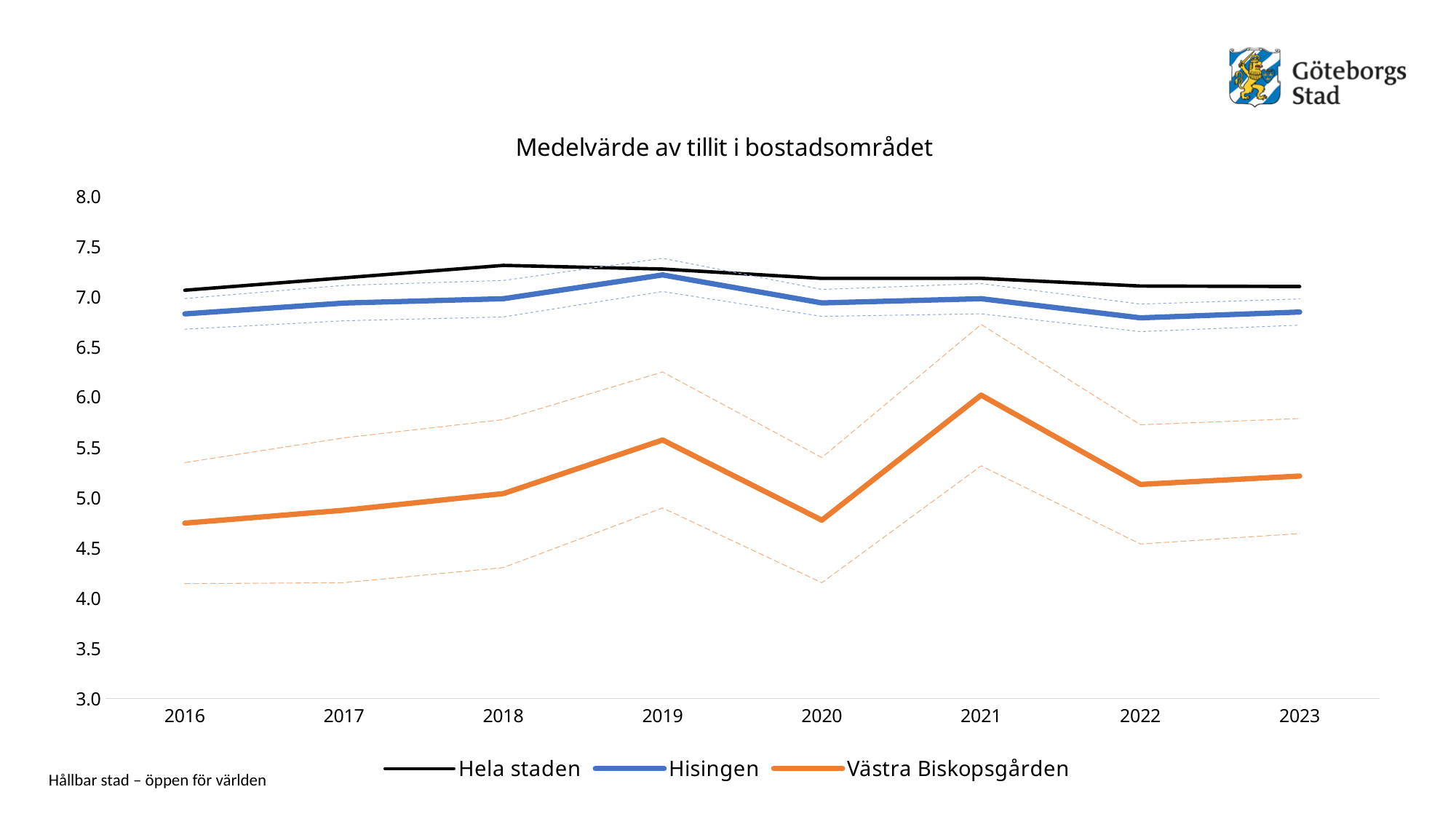
Is the value for Hisingen in 2022 greater or less than 7.0? less How many years are shown on the x axis? 8 Does the value for Västra Biskopsgården rise or fall from 2019 to 2020? fall Which series has the larger value in 2019, Hisingen or Västra Biskopsgården? Hisingen How many series does the legend list? 3 What is the title of the chart? Medelvärde av tillit i bostadsområdet Which series is drawn in orange? Västra Biskopsgården Is the value for Västra Biskopsgården in 2021 greater or less than 5.5? greater In which year does Hela staden reach its highest value? 2018 What kind of chart is shown on the slide? line chart In which year does Västra Biskopsgården reach its highest value? 2021 In which year does Hisingen reach its highest value? 2019